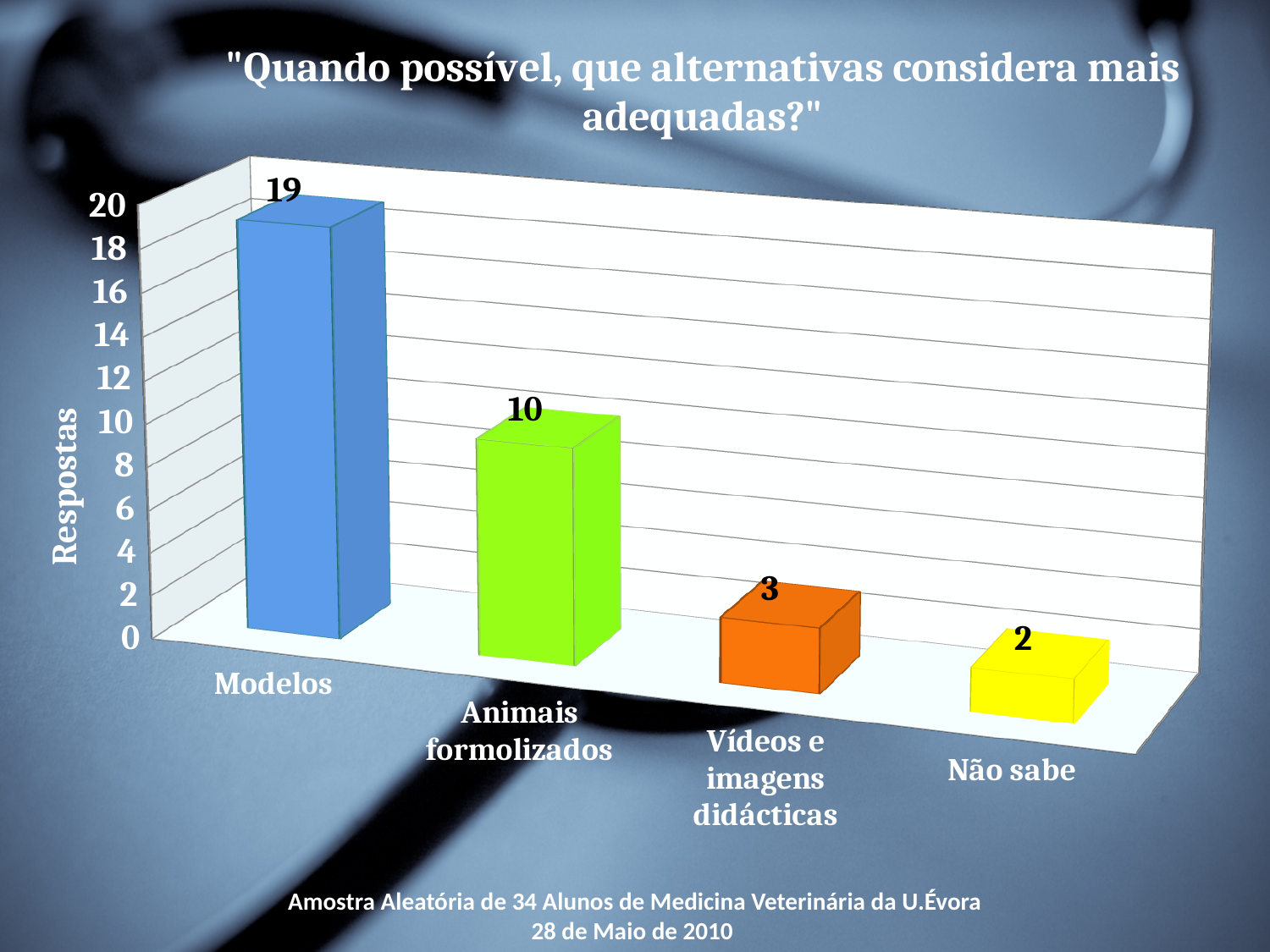
What is the value for Não sabe? 2 Which is larger, the value for Animais formolizados or the value for Vídeos e imagens didácticas? Animais formolizados How many categories are shown in the chart? 4 What is the value for Vídeos e imagens didácticas? 3 What colour is the bar for Não sabe? Yellow Which category has the highest value? Modelos What is the label of the vertical axis? Respostas Which category has the lowest value? Não sabe What is the value for Modelos? 19 What kind of chart is shown on the slide? Bar chart What is the difference between the values for Modelos and Animais formolizados? 9 What is the value for Animais formolizados? 10